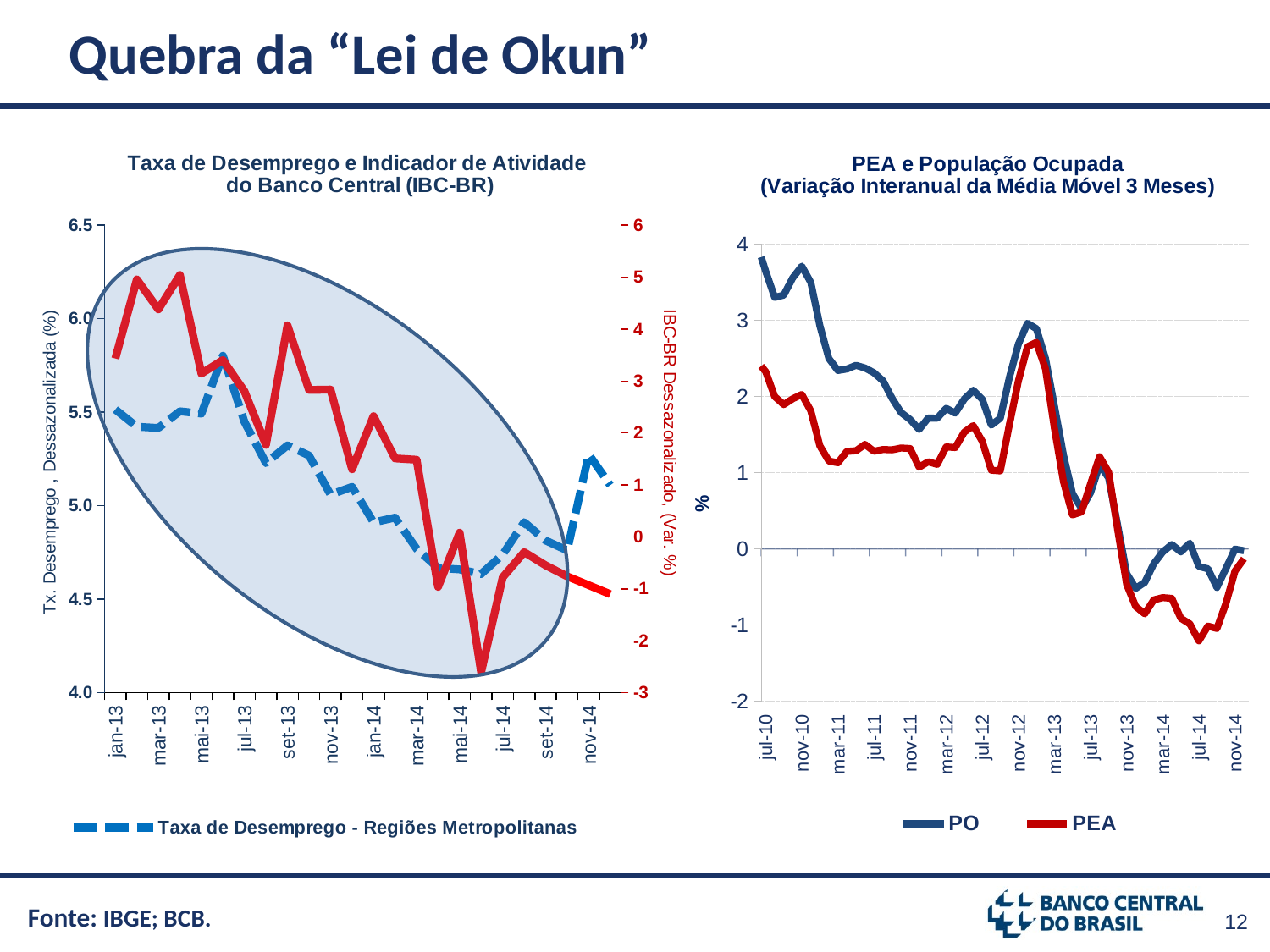
In the right chart 'PEA e População Ocupada', is the value of PEA at jul-14 greater or less than 0? less In the right chart 'PEA e População Ocupada', does the PO series overall rise or fall from jul-10 to nov-14? fall In the left chart, is the Taxa de Desemprego - Regiões Metropolitanas value at mai-14 greater or less than 5.0? less In the right chart 'PEA e População Ocupada', how many series does the legend list? 2 In the right chart 'PEA e População Ocupada', which series is higher at mar-11, PO or PEA? PO In the right chart 'PEA e População Ocupada', is the value of PO at nov-13 greater or less than 0? less In the right chart 'PEA e População Ocupada', what are the two series named in the legend? PO and PEA What kind of chart is the left chart, 'Taxa de Desemprego e Indicador de Atividade do Banco Central (IBC-BR)'? line chart In the left chart, what series name is shown in the legend below the chart? Taxa de Desemprego - Regiões Metropolitanas What kind of chart is the right chart, 'PEA e População Ocupada'? line chart